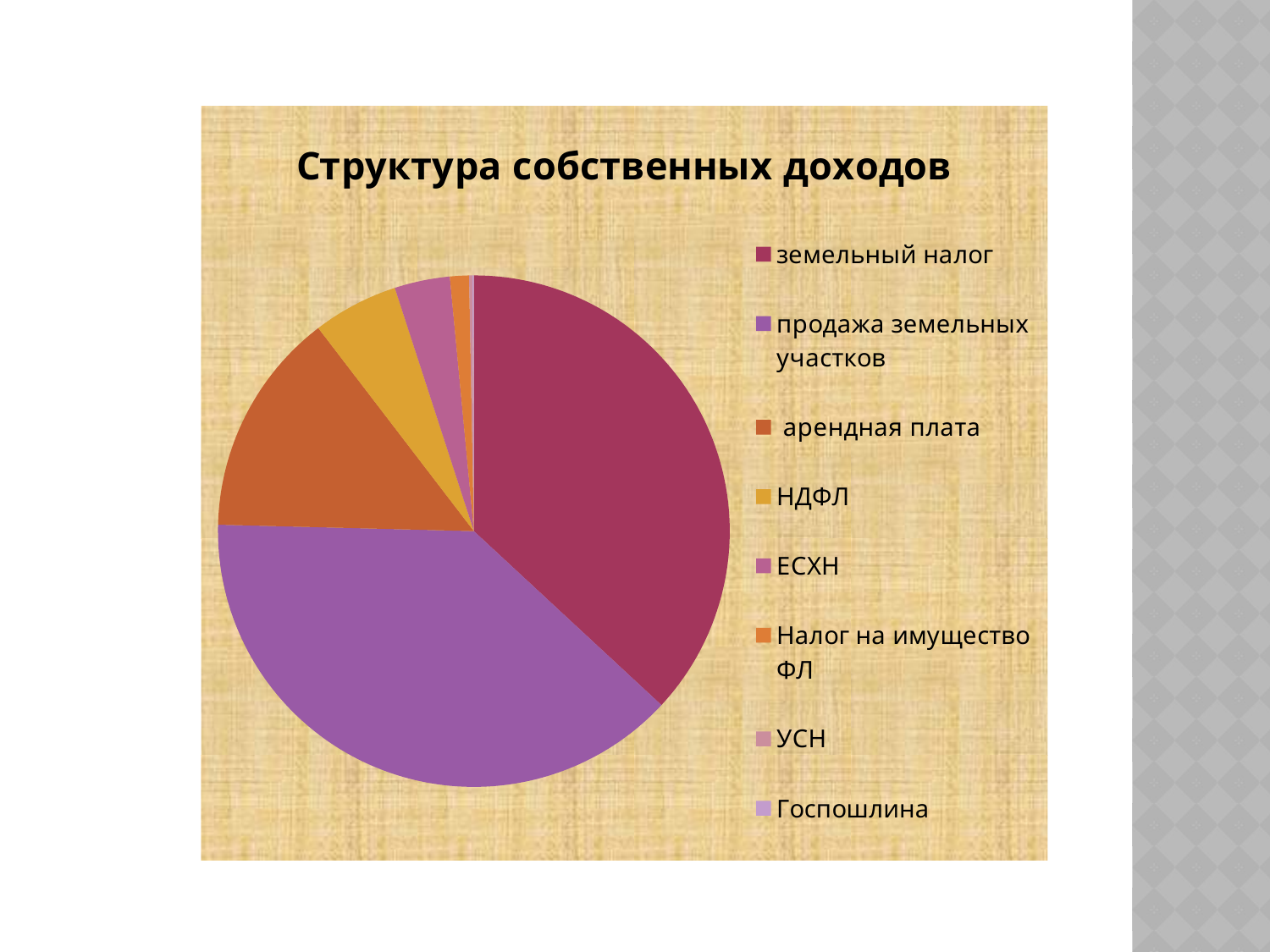
Which is larger in the pie chart: НДФЛ or ЕСХН? НДФЛ Which is larger in the pie chart: ЕСХН or Налог на имущество ФЛ? ЕСХН Which legend entry is listed first in the pie chart's legend? земельный налог Which is larger in the pie chart: земельный налог or арендная плата? земельный налог How many categories does the legend of the pie chart list? 8 What is the title of the chart? Структура собственных доходов What kind of chart is shown on the slide? pie chart